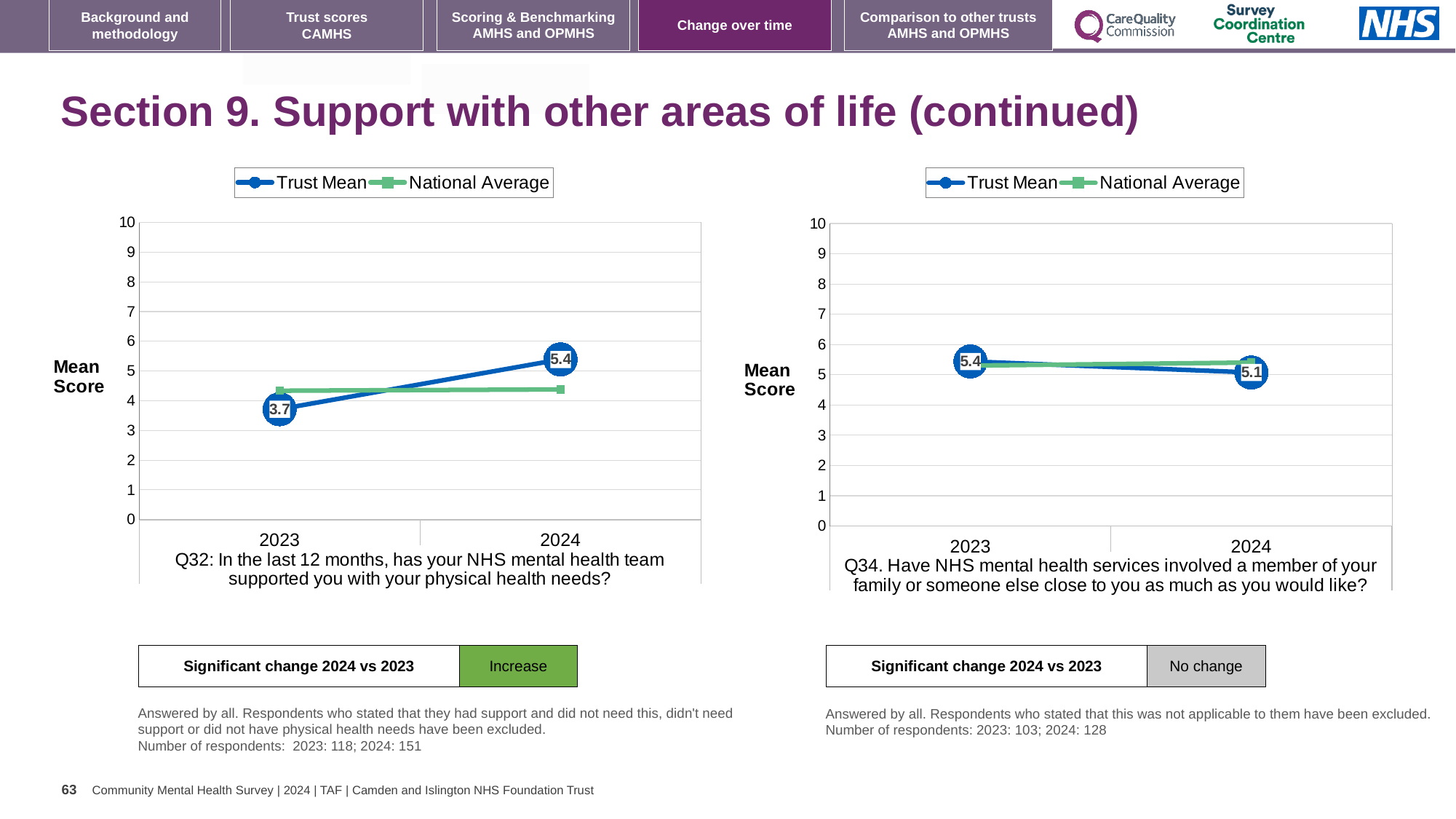
In the right chart (Q34), does the Trust Mean rise or fall from 2023 to 2024? fall In the left chart (Q32), is the National Average for 2023 greater or less than 5? less In the right chart (Q34), what is the Trust Mean for 2024? 5.1 In the right chart (Q34), what is the Trust Mean for 2023? 5.4 In the left chart (Q32), what is the Trust Mean for 2024? 5.4 In the left chart (Q32), which is larger in 2024, the Trust Mean or the National Average? Trust Mean In the left chart (Q32), by how much did the Trust Mean change from 2023 to 2024? 1.7 In the left chart (Q32), what is the Trust Mean for 2023? 3.7 In the left chart (Q32), does the Trust Mean rise or fall from 2023 to 2024? rise In the right chart (Q34), what is the difference between the Trust Mean in 2023 and 2024? 0.3 How many series does the legend of the right chart (Q34) list? 2 What type of chart is used on the left of the slide (Q32)? line chart